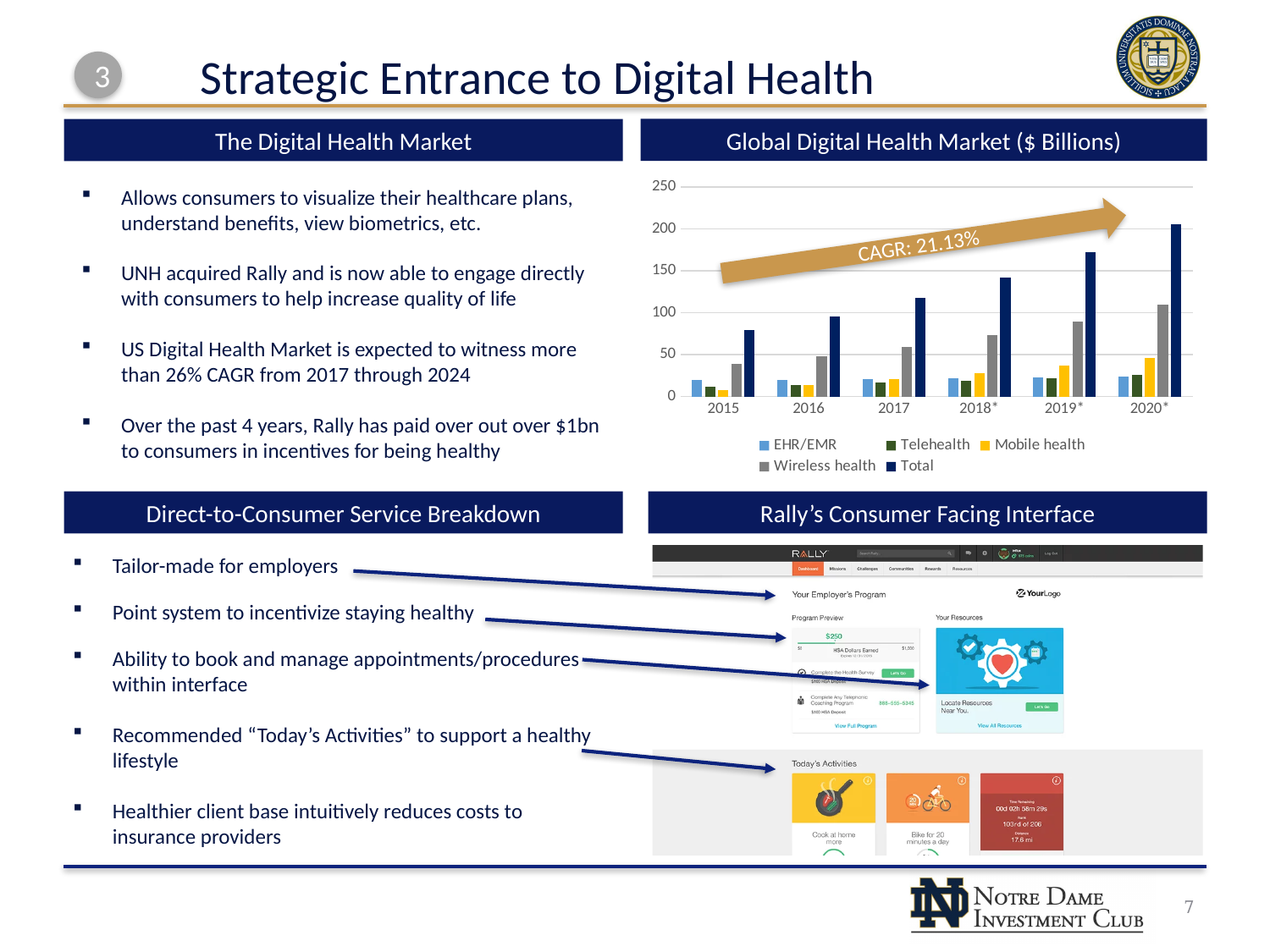
In the Global Digital Health Market chart, which year has the lowest Total value? 2015 In the Global Digital Health Market chart, is the Total value for 2020* greater or less than 200? greater How many years are shown on the x axis of the Global Digital Health Market chart? 6 What kind of chart is shown under "Global Digital Health Market ($ Billions)"? bar chart How many series does the legend of the Global Digital Health Market chart list? 5 In the Global Digital Health Market chart, is the Wireless health value for 2020* greater or less than 100? greater In the Global Digital Health Market chart, which year has the highest Total value? 2020* In the Global Digital Health Market chart, which is larger in 2019*: Wireless health or Mobile health? Wireless health In the Global Digital Health Market chart, is the Total value for 2015 greater or less than 100? less What CAGR is annotated on the arrow in the Global Digital Health Market chart? 21.13% What unit is given in the title of the Global Digital Health Market chart? $ Billions In the Global Digital Health Market chart, does the Total series rise or fall from 2015 to 2020*? rise